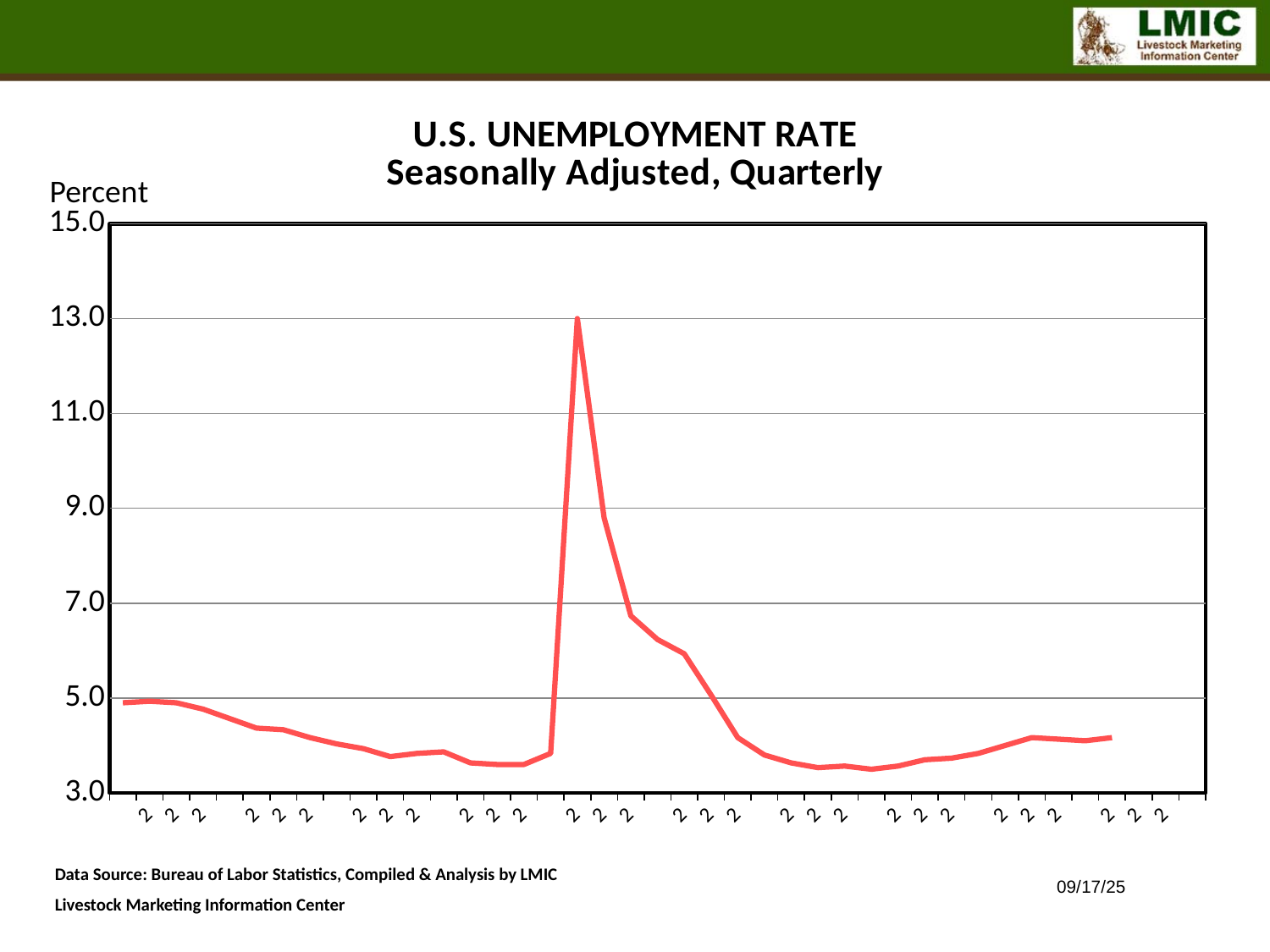
Does the unemployment rate line rise or fall in the quarters immediately before its peak? rise How many data series are plotted on the chart? 1 What kind of chart is shown on the slide? line chart What is the highest tick value shown on the vertical axis? 15.0 Does the unemployment rate line rise or fall in the quarters immediately after its peak? fall Is the last plotted value of the unemployment rate line greater or less than 5.0? less Is the lowest value of the unemployment rate line greater or less than 5.0? less What is the title of the chart? U.S. UNEMPLOYMENT RATE Seasonally Adjusted, Quarterly What unit is labeled on the vertical axis of the chart? Percent Is the peak value of the unemployment rate line greater or less than 11.0? greater